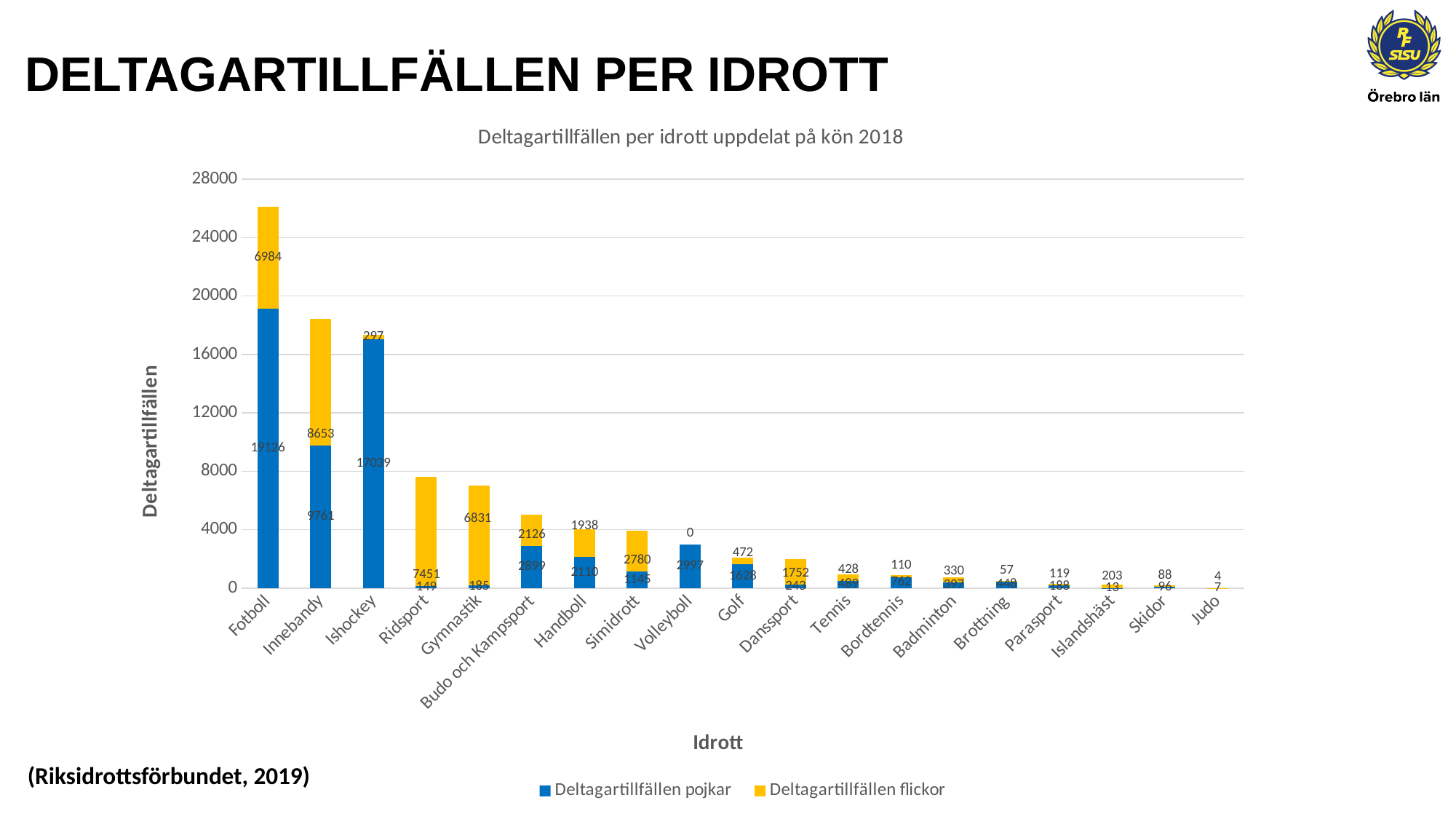
Is the total value for Ridsport greater or less than 4000? greater What is the value for Deltagartillfällen flickor for Innebandy? 8653 What is the difference between the pojkar and flickor values for Innebandy? 1108 How many sports (categories) are shown on the x axis? 19 What kind of chart is shown on the slide? Stacked bar chart Which sport has the highest total number of deltagartillfällen? Fotboll For Simidrott, which is larger: the pojkar value or the flickor value? Flickor How many series does the legend list? 2 How many participation occasions (deltagartillfällen) for pojkar are shown for Fotboll? 19126 What is the value for Deltagartillfällen flickor for Volleyboll? 0 What is the total number of deltagartillfällen (pojkar plus flickor) for Fotboll? 26110 What is the value for Deltagartillfällen flickor for Ridsport? 7451